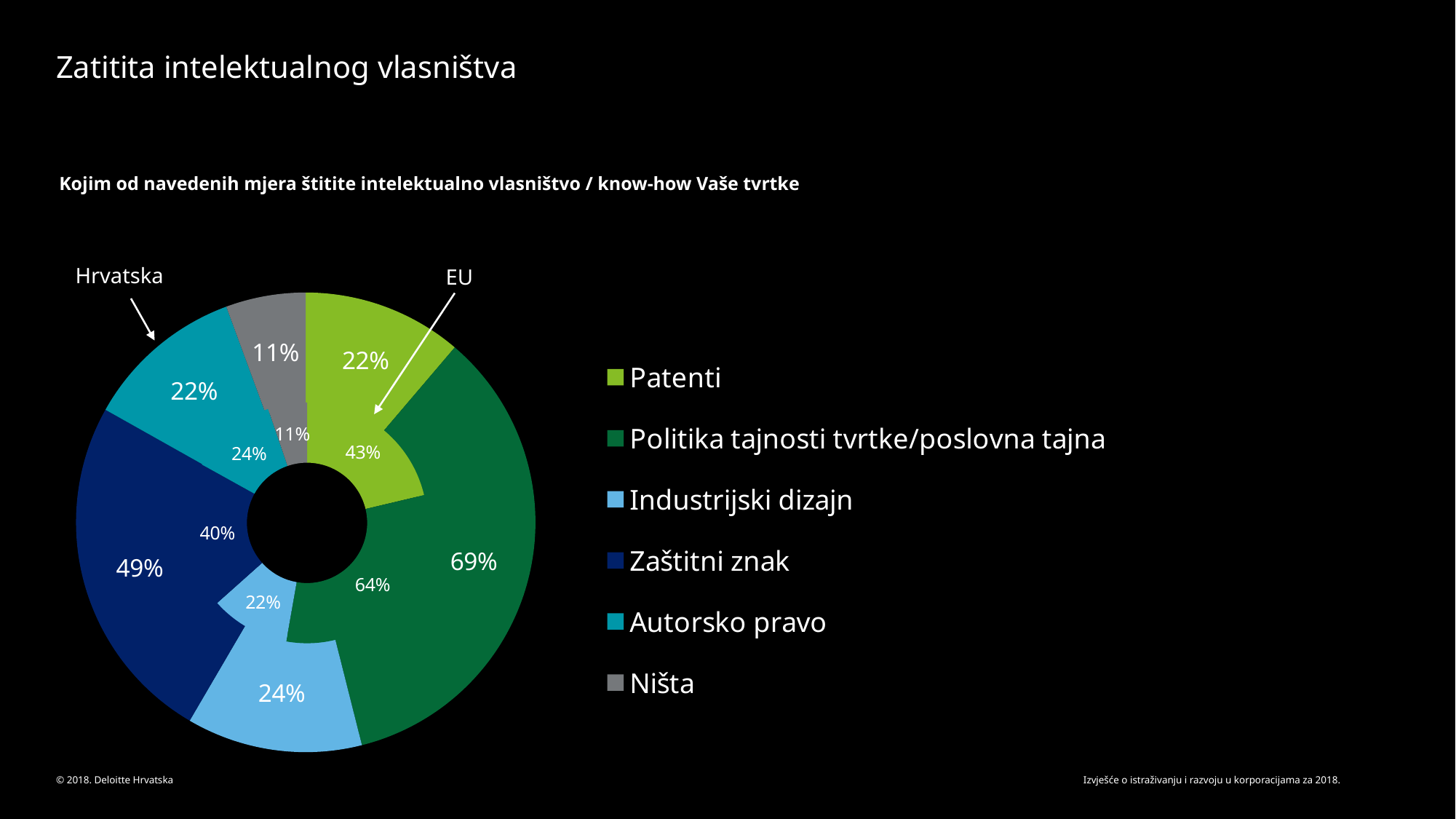
Which is larger for Autorsko pravo, the Hrvatska value or the EU value? EU What is the EU value for Patenti? 43% Which measure has the lowest value for EU? Ništa What is the difference between the Hrvatska and EU values for Patenti? 21% What percentage of Hrvatska respondents use Politika tajnosti tvrtke/poslovna tajna? 69% How many measures (categories) does the chart show? 6 What is the Hrvatska value for Zaštitni znak? 49% What is the EU value for Industrijski dizajn? 22% What is the difference between the Hrvatska and EU values for Zaštitni znak? 9% What kind of chart is shown on the slide? Doughnut (pie) chart Which measure has the highest value for Hrvatska? Politika tajnosti tvrtke/poslovna tajna How many entries does the legend list? 6